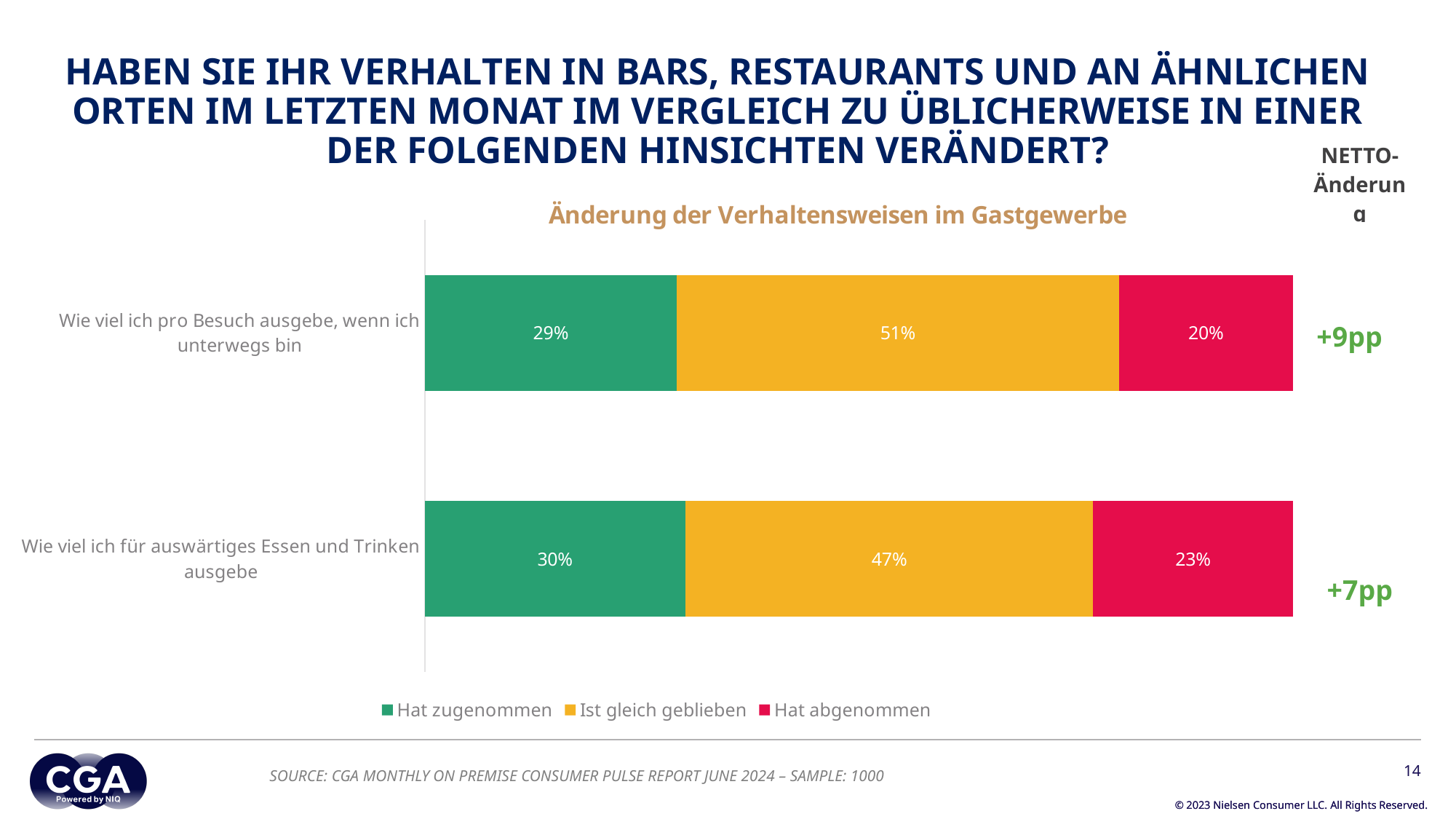
How many categories are shown in the chart? 2 What is the NETTO-Änderung shown for "Wie viel ich pro Besuch ausgebe, wenn ich unterwegs bin"? +9pp Which category has the higher "Ist gleich geblieben" value? Wie viel ich pro Besuch ausgebe, wenn ich unterwegs bin How many series does the legend list? 3 What kind of chart is shown on the slide? Stacked bar chart What is the value of "Hat zugenommen" for "Wie viel ich pro Besuch ausgebe, wenn ich unterwegs bin"? 29% What is the value of "Ist gleich geblieben" for "Wie viel ich für auswärtiges Essen und Trinken ausgebe"? 47% What is the total of the stacked bar for "Wie viel ich für auswärtiges Essen und Trinken ausgebe"? 100% What is the value of "Hat abgenommen" for "Wie viel ich für auswärtiges Essen und Trinken ausgebe"? 23% What is the difference between the "Ist gleich geblieben" values of the two categories? 4 percentage points What is the value of "Hat abgenommen" for "Wie viel ich pro Besuch ausgebe, wenn ich unterwegs bin"? 20% Which is larger: "Hat abgenommen" for "Wie viel ich pro Besuch ausgebe, wenn ich unterwegs bin" or for "Wie viel ich für auswärtiges Essen und Trinken ausgebe"? Wie viel ich für auswärtiges Essen und Trinken ausgebe